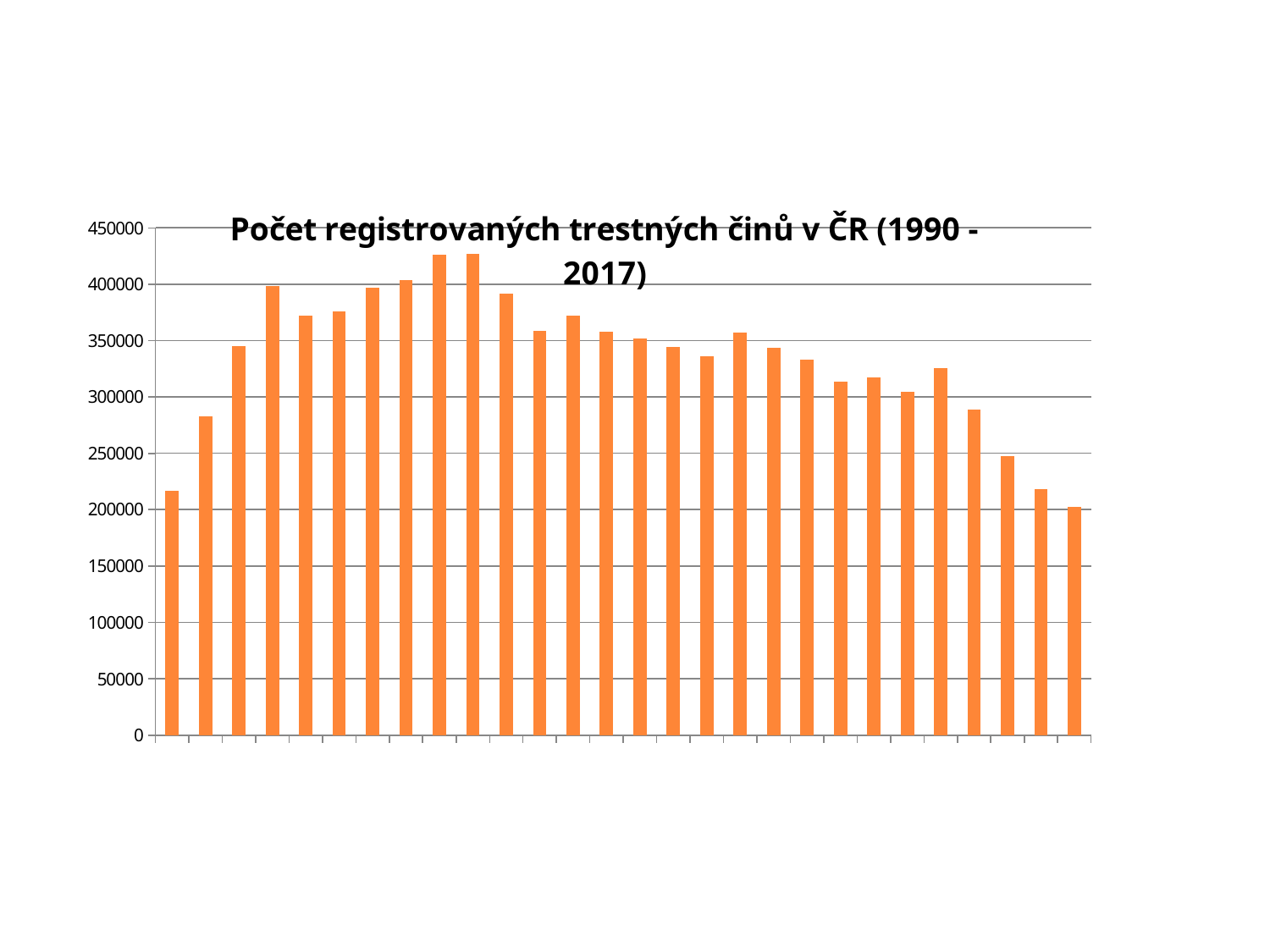
Which is larger, the value of the first bar or the last bar? the first bar What kind of chart is shown on the slide? bar chart What colour are the bars in the chart? orange Is the value of the first bar greater or less than 200000? greater How many bars are plotted in the chart? 28 Is the value of the tallest bar greater or less than 400000? greater Which is larger, the value of the third bar or the fourth bar? the fourth bar Is the value of the last bar greater or less than 250000? less Do the values rise or fall across the first four bars of the chart? rise What is the title of the chart? Počet registrovaných trestných činů v ČR (1990 - 2017) Do the values rise or fall across the last five bars of the chart? fall